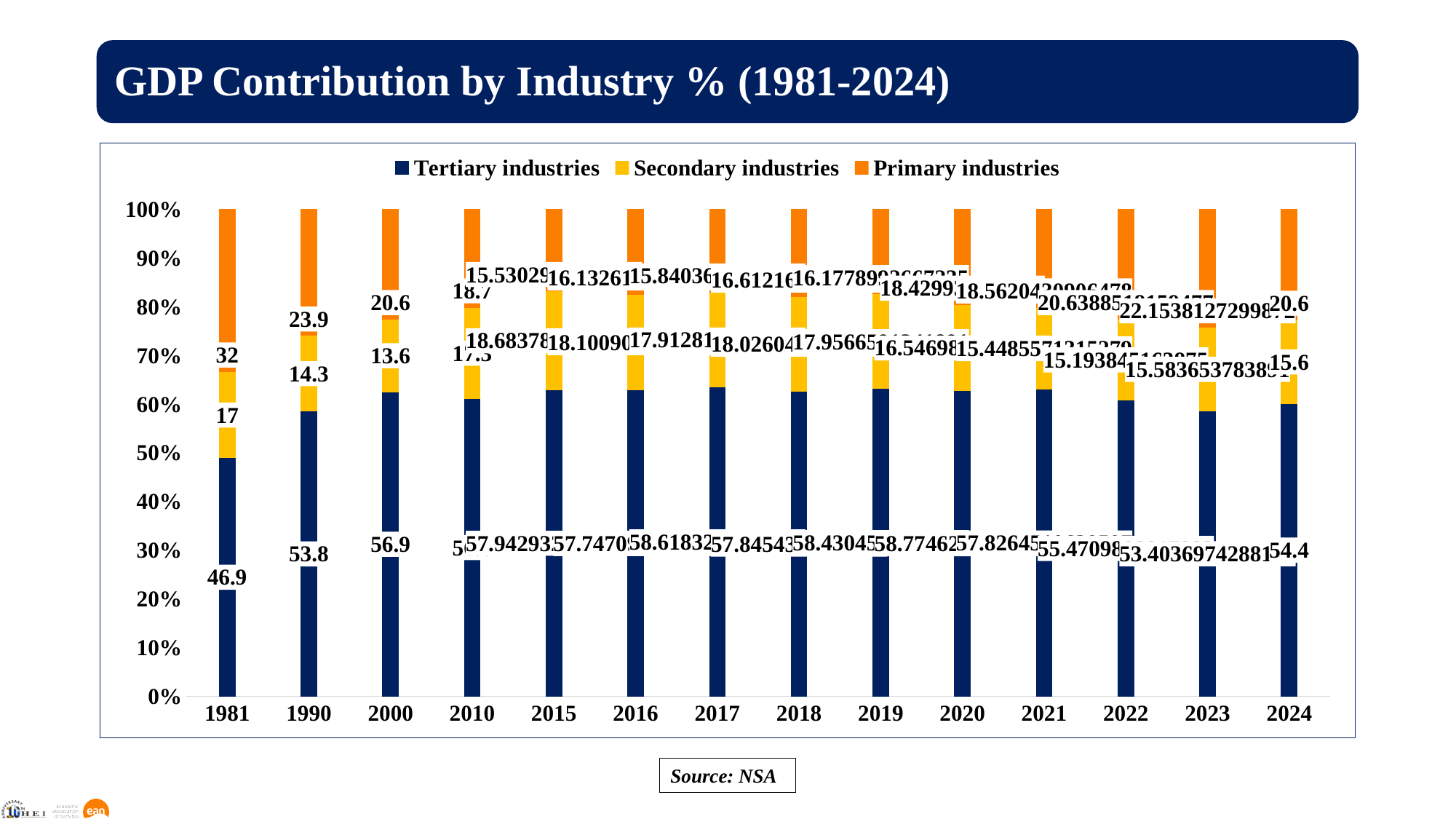
Is the Tertiary industries value for 2023 greater or less than 50%? greater Which is larger, the Primary industries value in 1981 or in 1990? 1981 What is the value for Secondary industries in 1990? 14.3 What is the value for Tertiary industries in 1981? 46.9 What type of chart is shown on the slide? stacked bar chart What is the value for Tertiary industries in 2000? 56.9 Which series is shown in orange in the legend? Primary industries How many years are shown on the x axis? 14 How many series does the legend list? 3 What is the difference between the Tertiary industries values for 1990 and 1981? 6.9 What is the value for Primary industries in 2024? 20.6 What is the value for Primary industries in 1981? 32